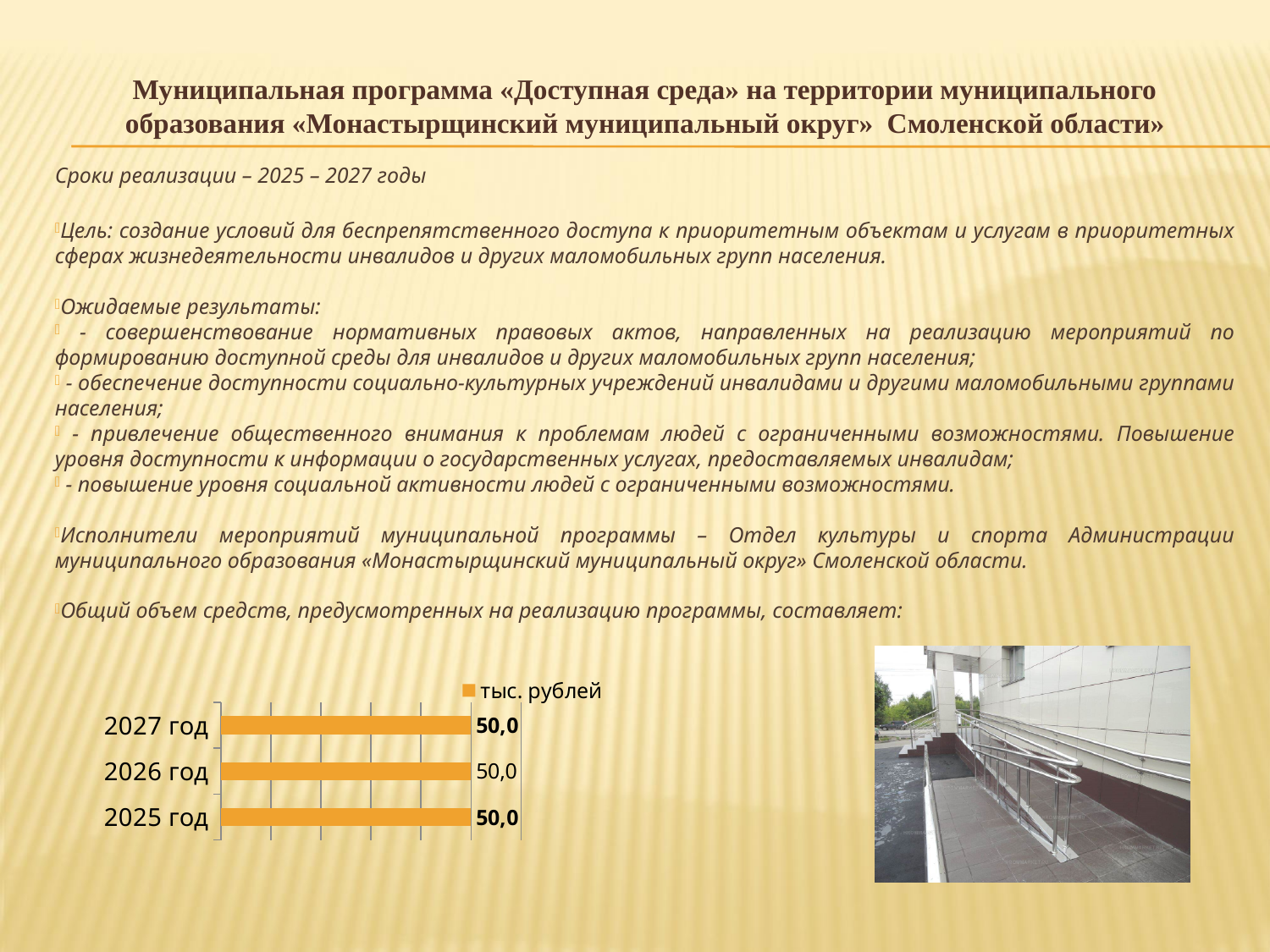
Do the values rise, fall, or stay the same from 2025 год to 2027 год? stay the same How many categories (years) are shown in the bar chart? 3 What is the value for 2027 год in the bar chart? 50,0 What colour are the bars in the chart? orange What is the difference between the values for 2027 год and 2025 год? 0,0 How many series does the chart legend list? 1 What is the name of the series shown in the chart legend? тыс. рублей What is the value for 2026 год in the bar chart? 50,0 What kind of chart is shown on the slide? bar chart What is the value for 2025 год in the bar chart? 50,0